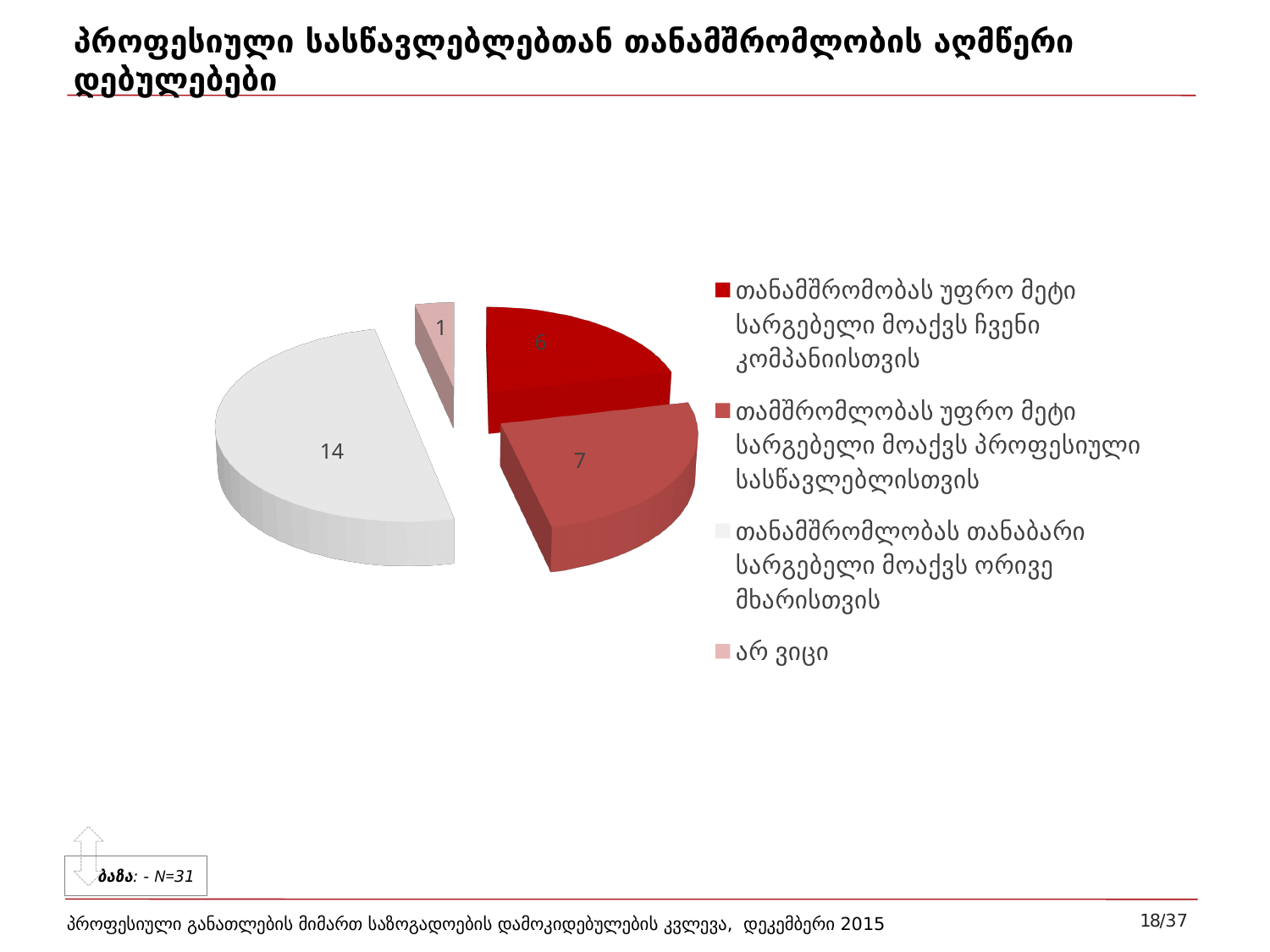
How many slices does the pie chart have? 4 What is the value for "არ ვიცი"? 1 How many entries does the legend list? 4 What is the value for "თანამშრომლობას თანაბარი სარგებელი მოაქვს ორივე მხარისთვის"? 14 Which category has the smallest slice? არ ვიცი What type of chart is shown on the slide? pie chart What is the value for "თამშრომლობას უფრო მეტი სარგებელი მოაქვს პროფესიული სასწავლებლისთვის"? 7 Which category has the largest slice? თანამშრომლობას თანაბარი სარგებელი მოაქვს ორივე მხარისთვის Which is larger: the value for "თამშრომლობას უფრო მეტი სარგებელი მოაქვს პროფესიული სასწავლებლისთვის" or the value for "თანამშრომობას უფრო მეტი სარგებელი მოაქვს ჩვენი კომპანიისთვის"? თამშრომლობას უფრო მეტი სარგებელი მოაქვს პროფესიული სასწავლებლისთვის What colour is the slice for "არ ვიცი"? light pink What is the value for "თანამშრომობას უფრო მეტი სარგებელი მოაქვს ჩვენი კომპანიისთვის"? 6 What is the difference between the value for "თანამშრომლობას თანაბარი სარგებელი მოაქვს ორივე მხარისთვის" and the value for "არ ვიცი"? 13